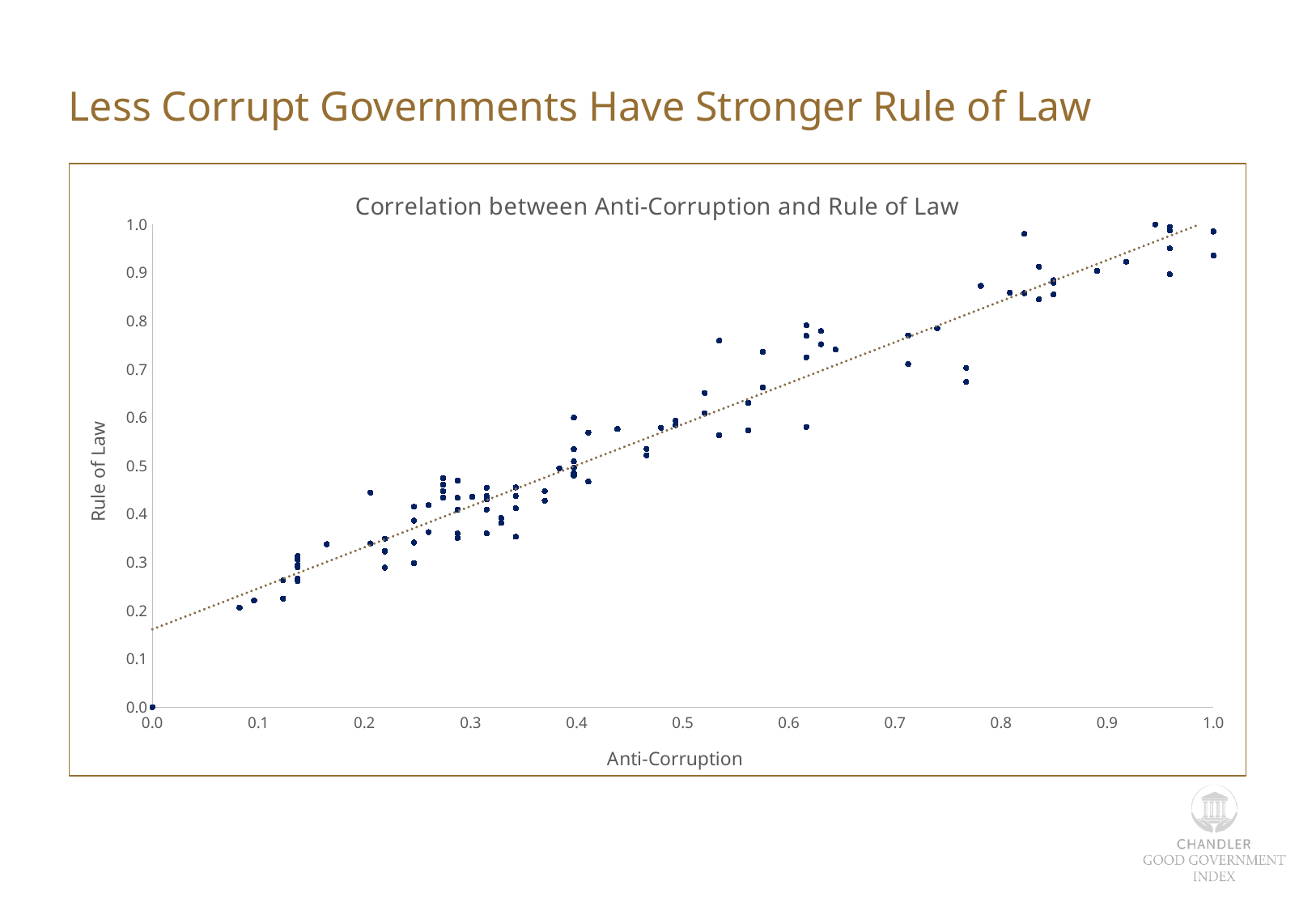
Is the Rule of Law value of the lowest point near Anti-Corruption 0.22 greater or less than 0.4? less What is the title of the chart? Correlation between Anti-Corruption and Rule of Law Is the Rule of Law value of the highest point near Anti-Corruption 0.95 greater or less than 0.9? greater Do the Rule of Law values generally rise or fall as Anti-Corruption increases along the x axis? rise What is the Rule of Law value of the point plotted at Anti-Corruption 0.0? 0.0 What variable is plotted on the horizontal axis of the chart? Anti-Corruption Are the Rule of Law values for the points at Anti-Corruption 1.0 greater or less than 0.9? greater What kind of chart is shown on the slide? scatter chart Does the dotted trend line in the chart slope upward or downward from left to right? upward